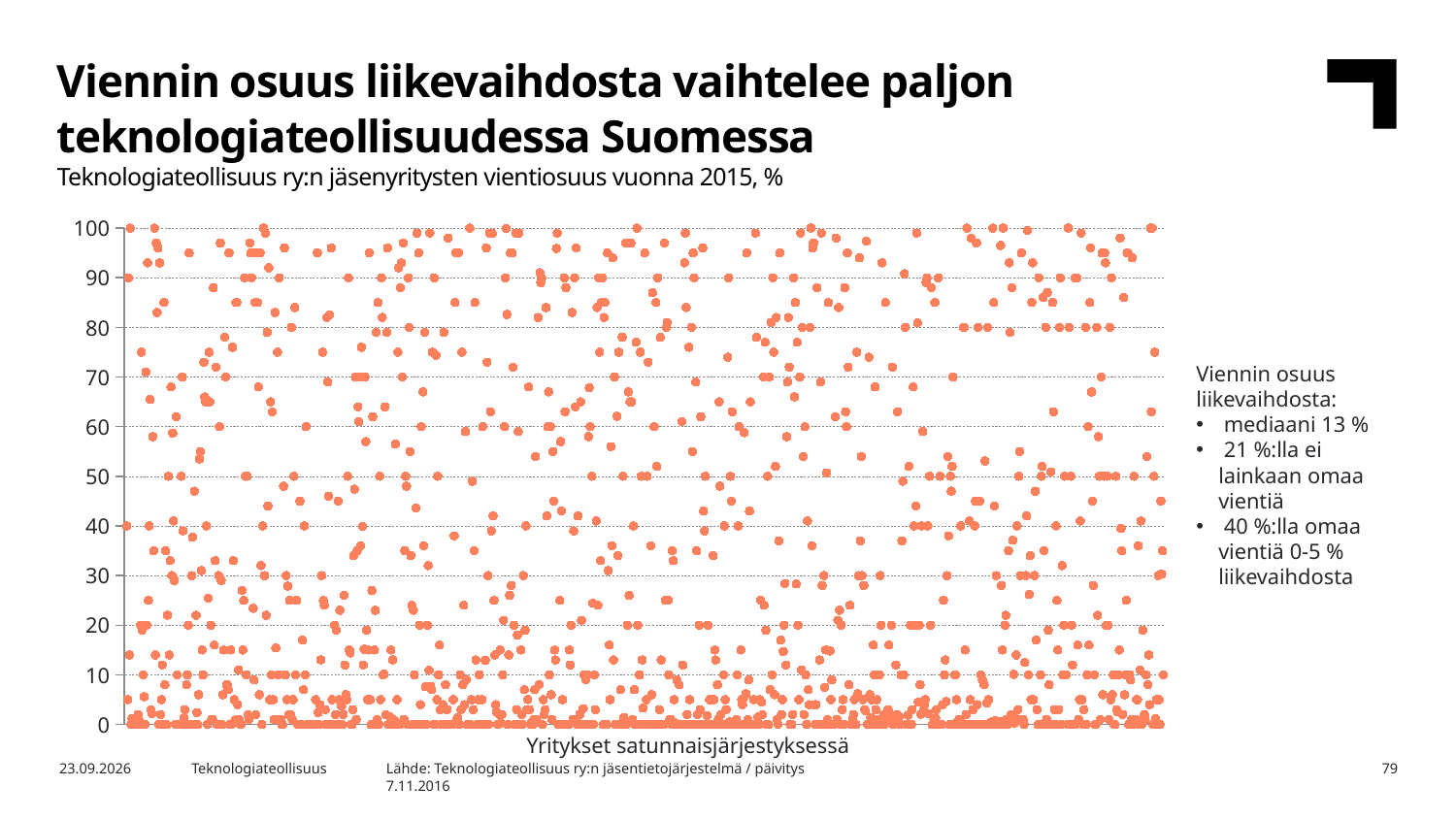
What is the highest value shown on the y axis of the chart? 100 According to the slide, what percentage of companies have no exports at all? 21 % According to the slide, what percentage of companies have exports of 0-5 % of turnover? 40 % What is the interval between consecutive tick marks on the y axis? 10 According to the slide, what is the median export share of turnover (mediaani)? 13 % What is the label of the x axis of the chart? Yritykset satunnaisjärjestyksessä Which year does the chart's data refer to? 2015 What kind of chart is shown on the slide? scatter chart What is the lowest value shown on the y axis of the chart? 0